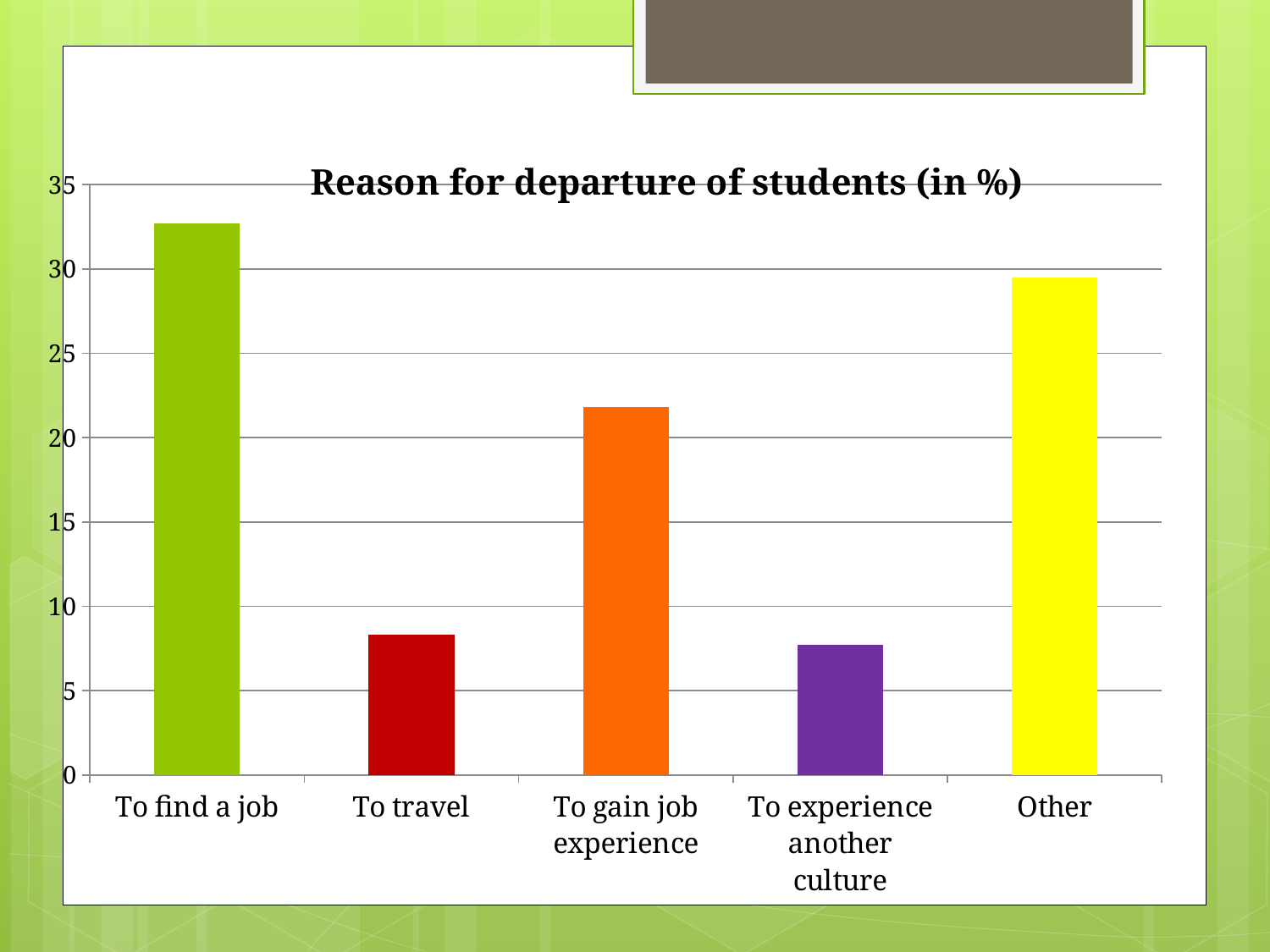
Is the value for To gain job experience greater or less than 20? greater What kind of chart is shown on the slide? bar chart What is the title of the chart? Reason for departure of students (in %) Which is larger, the value for To gain job experience or the value for To travel? To gain job experience Is the value for To travel greater or less than 10? less Which is larger, the value for To find a job or the value for Other? To find a job Is the value for To find a job greater or less than 30? greater Which reason for departure has the highest value? To find a job What colour is the bar for Other? yellow How many reasons (categories) are shown in the chart? 5